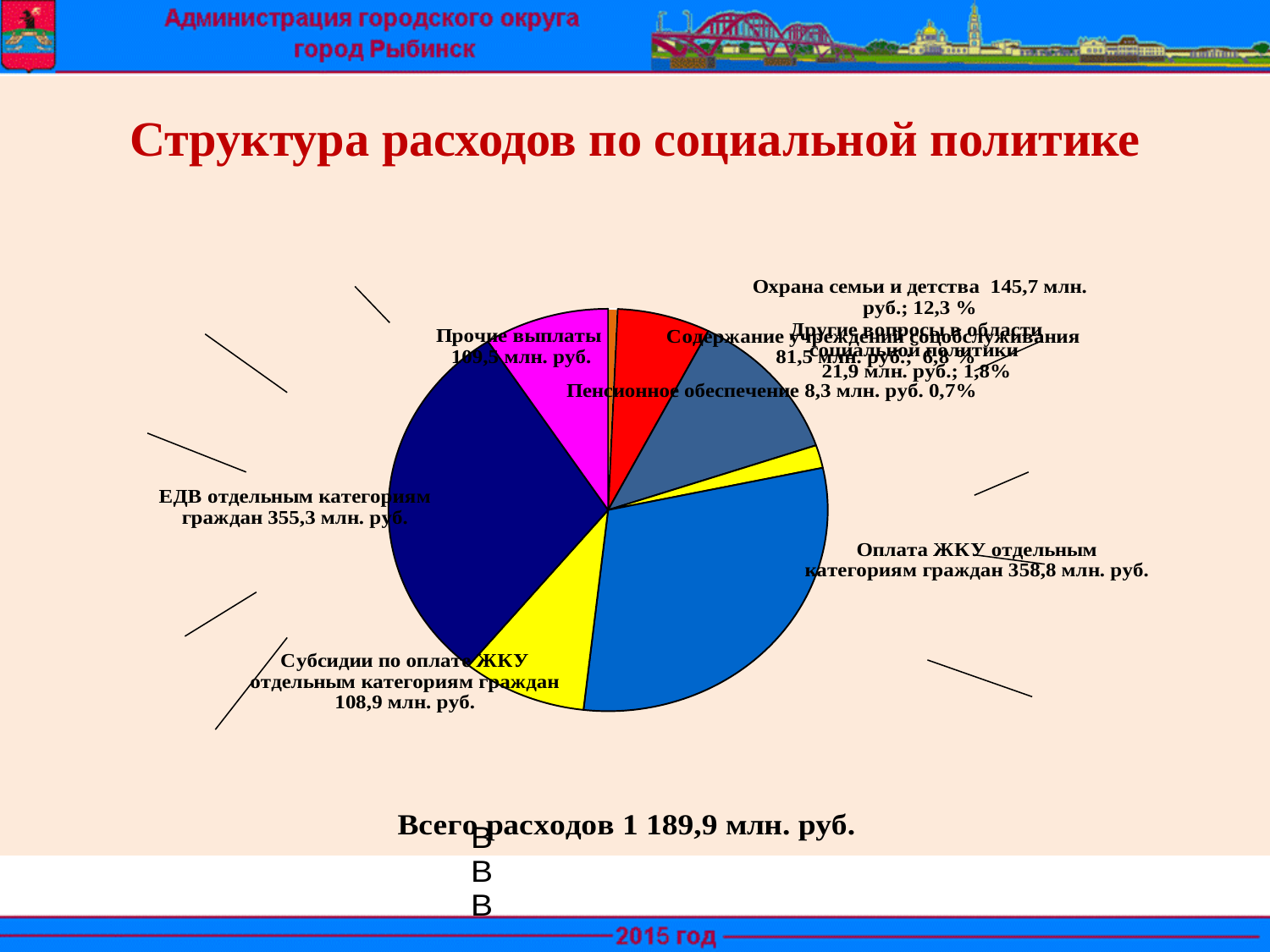
What is the value for Охрана семьи и детства? 145,7 млн. руб. What is the total of all expenditures shown on the slide? 1 189,9 млн. руб. What is the title of the chart? Структура расходов по социальной политике Which category has the smallest value? Пенсионное обеспечение What is the value for Субсидии по оплате ЖКУ отдельным категориям граждан? 108,9 млн. руб. What share of the pie does Охрана семьи и детства represent? 12,3 % Which is larger: Охрана семьи и детства or Субсидии по оплате ЖКУ отдельным категориям граждан? Охрана семьи и детства What kind of chart is shown on the slide? pie chart What is the value for ЕДВ отдельным категориям граждан? 355,3 млн. руб. What is the value for Оплата ЖКУ отдельным категориям граждан? 358,8 млн. руб. What is the value for Пенсионное обеспечение? 8,3 млн. руб. What is the difference between Оплата ЖКУ отдельным категориям граждан and ЕДВ отдельным категориям граждан? 3,5 млн. руб.